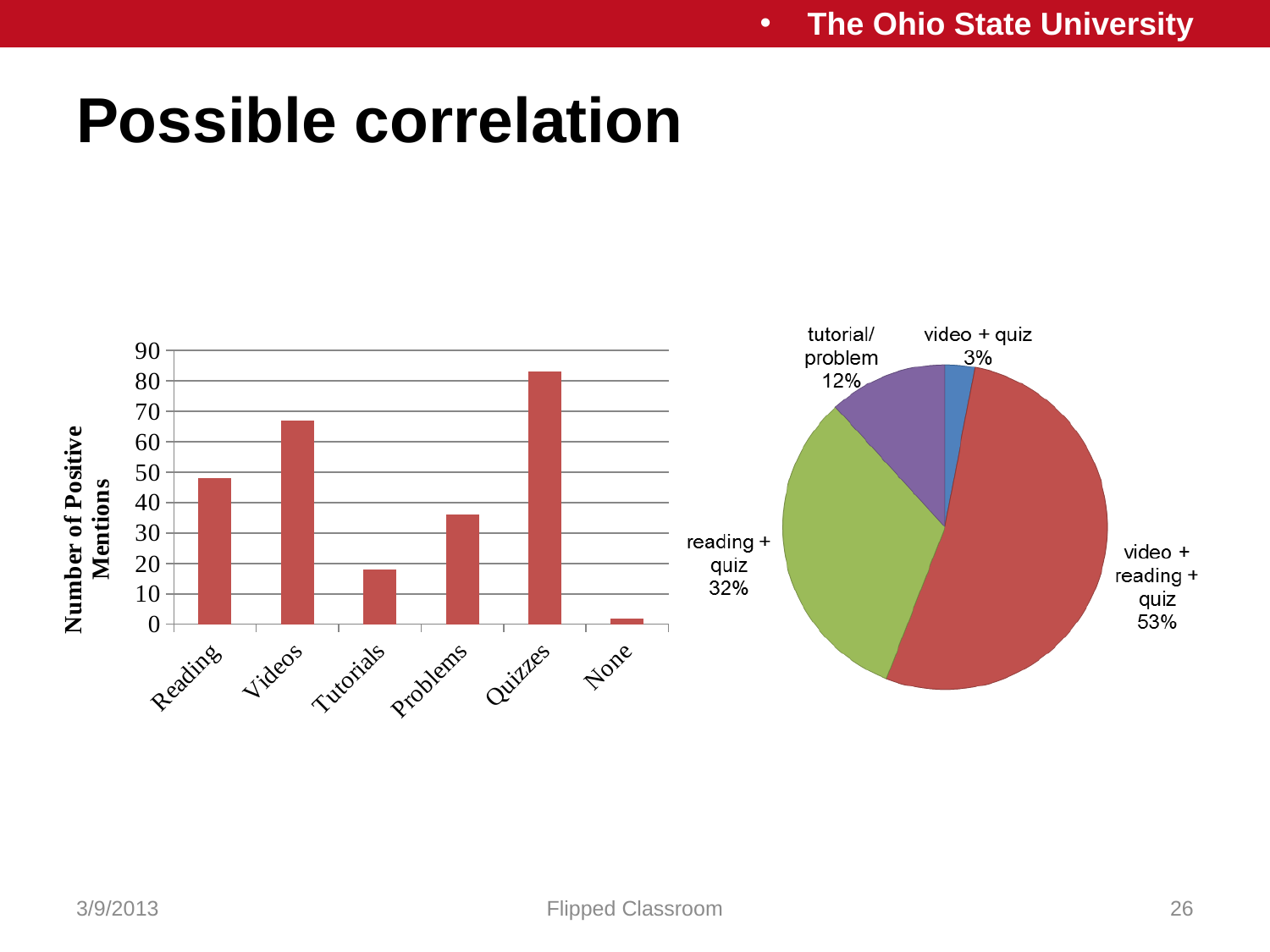
In the bar chart on the left, which category has the highest number of positive mentions? Quizzes In the pie chart on the right, which slice is the smallest? video + quiz In the pie chart on the right, what is the difference in percentage points between reading + quiz and video + quiz? 29 In the pie chart on the right, what share is labelled for video + reading + quiz? 53% In the bar chart on the left, which has more positive mentions, Videos or Problems? Videos How many categories are shown in the bar chart on the left? 6 In the bar chart on the left, which category has the lowest number of positive mentions? None In the pie chart on the right, what share is labelled for tutorial/problem? 12% In the bar chart on the left, is the value for Reading greater or less than 40? greater What kind of chart is the chart on the left of the slide? bar chart In the bar chart on the left, is the value for Quizzes greater or less than 80? greater In the bar chart on the left, is the value for Tutorials greater or less than 20? less